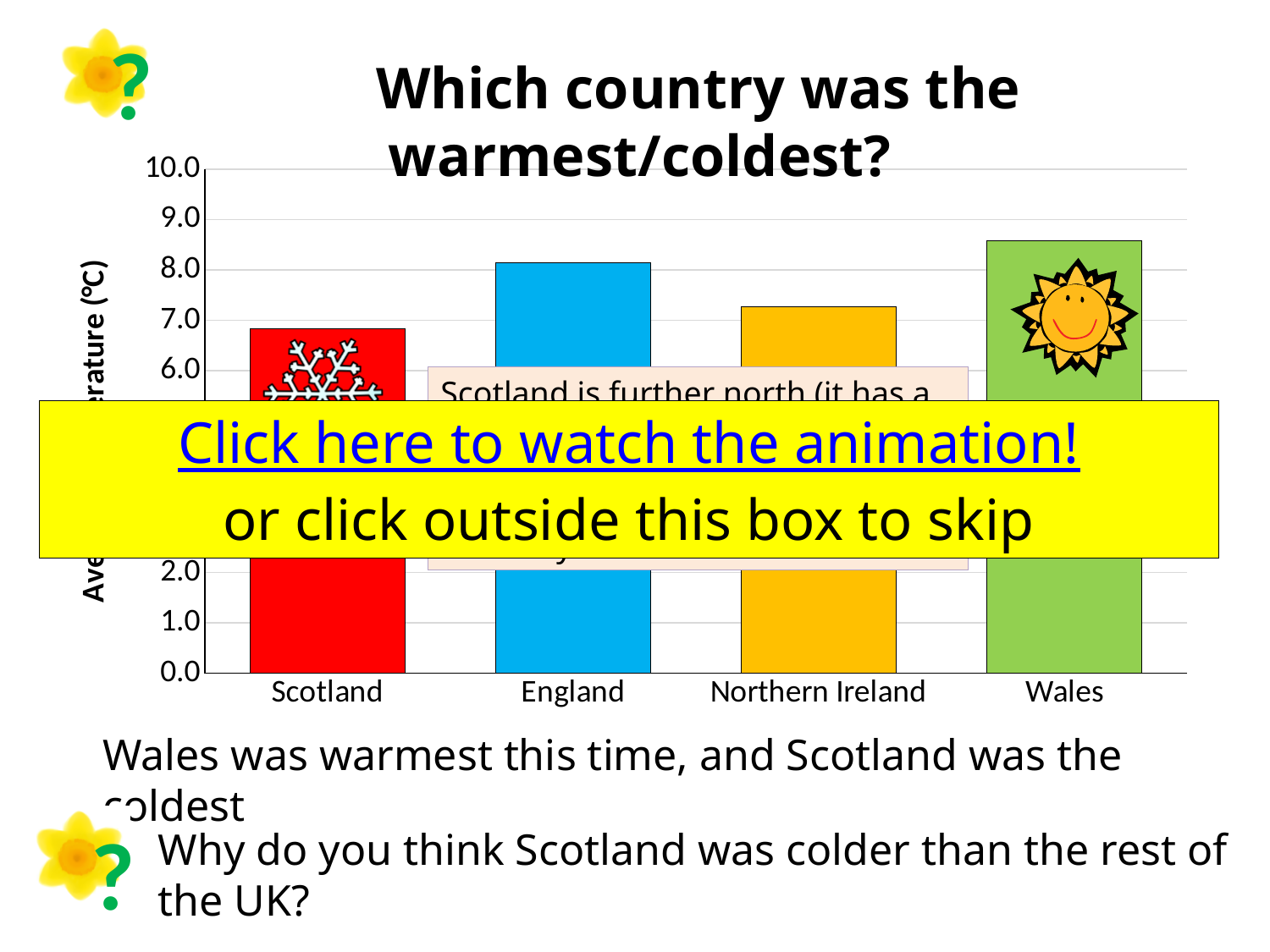
What is the highest value shown on the y axis of the chart? 10.0 What kind of chart is shown on the slide? bar chart Which has the higher value, Wales or Scotland? Wales Which has the higher value, England or Northern Ireland? England Which country has the highest bar in the chart? Wales Is the value for Northern Ireland greater or less than 7.0? greater Is the value for England greater or less than 8.0? greater What colour is the bar for Wales? green How many countries are shown on the x axis of the chart? 4 Is the value for Wales greater or less than 8.0? greater Which country has the lowest bar in the chart? Scotland